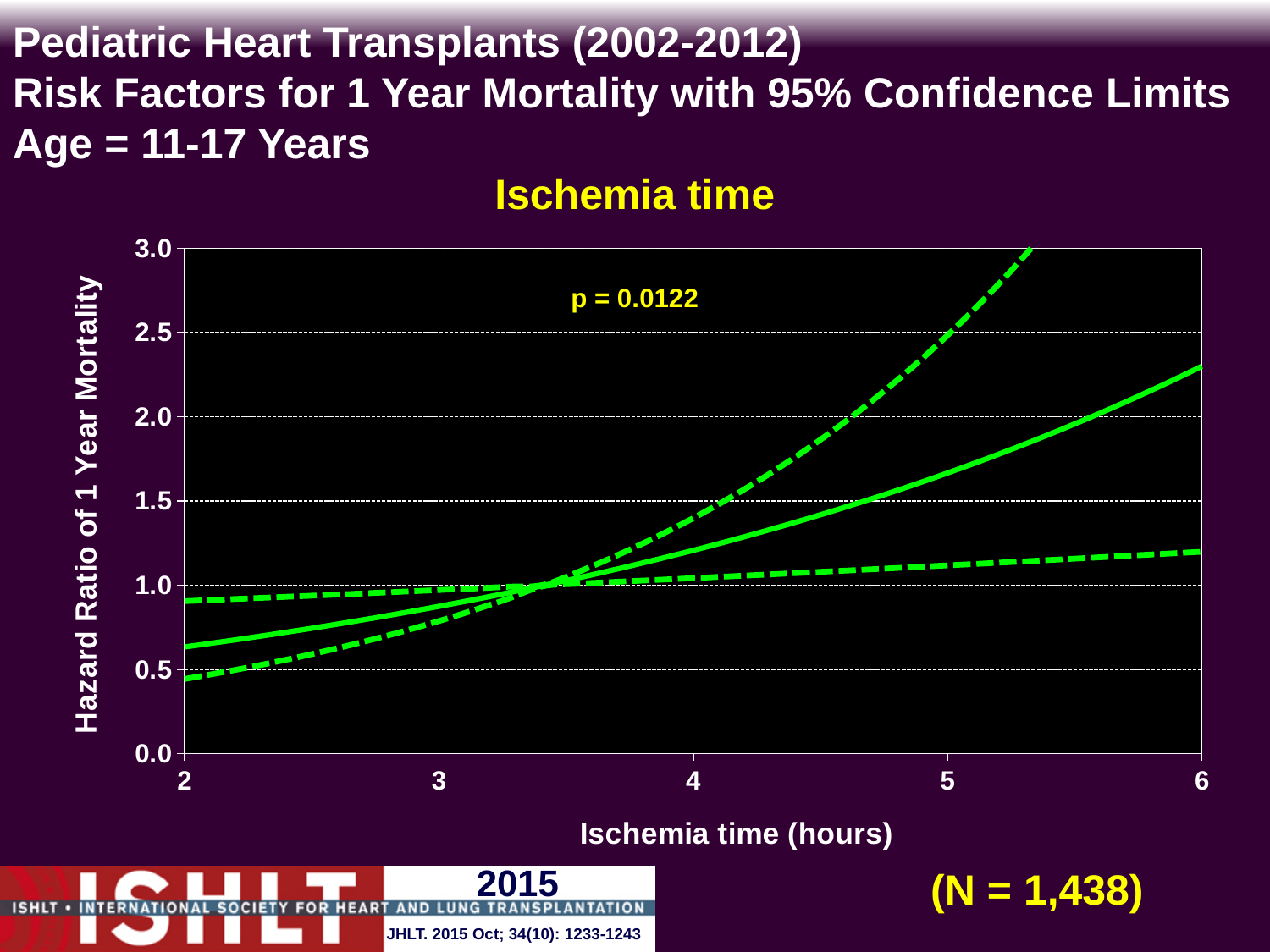
Is the hazard ratio (solid line) at an ischemia time of 6 hours greater or less than 2.0? greater What p-value is printed on the chart? p = 0.0122 Is the lower confidence limit (lower dashed line) at an ischemia time of 6 hours greater or less than 1.5? less How many tick labels are shown on the x axis? 5 What kind of chart is shown on the slide? line chart Is the hazard ratio (solid line) at an ischemia time of 4 hours greater or less than 1.0? greater Does the solid hazard ratio line rise or fall as ischemia time increases from 2 to 6 hours? rise What is the label of the y axis? Hazard Ratio of 1 Year Mortality How many lines are plotted on the chart? 3